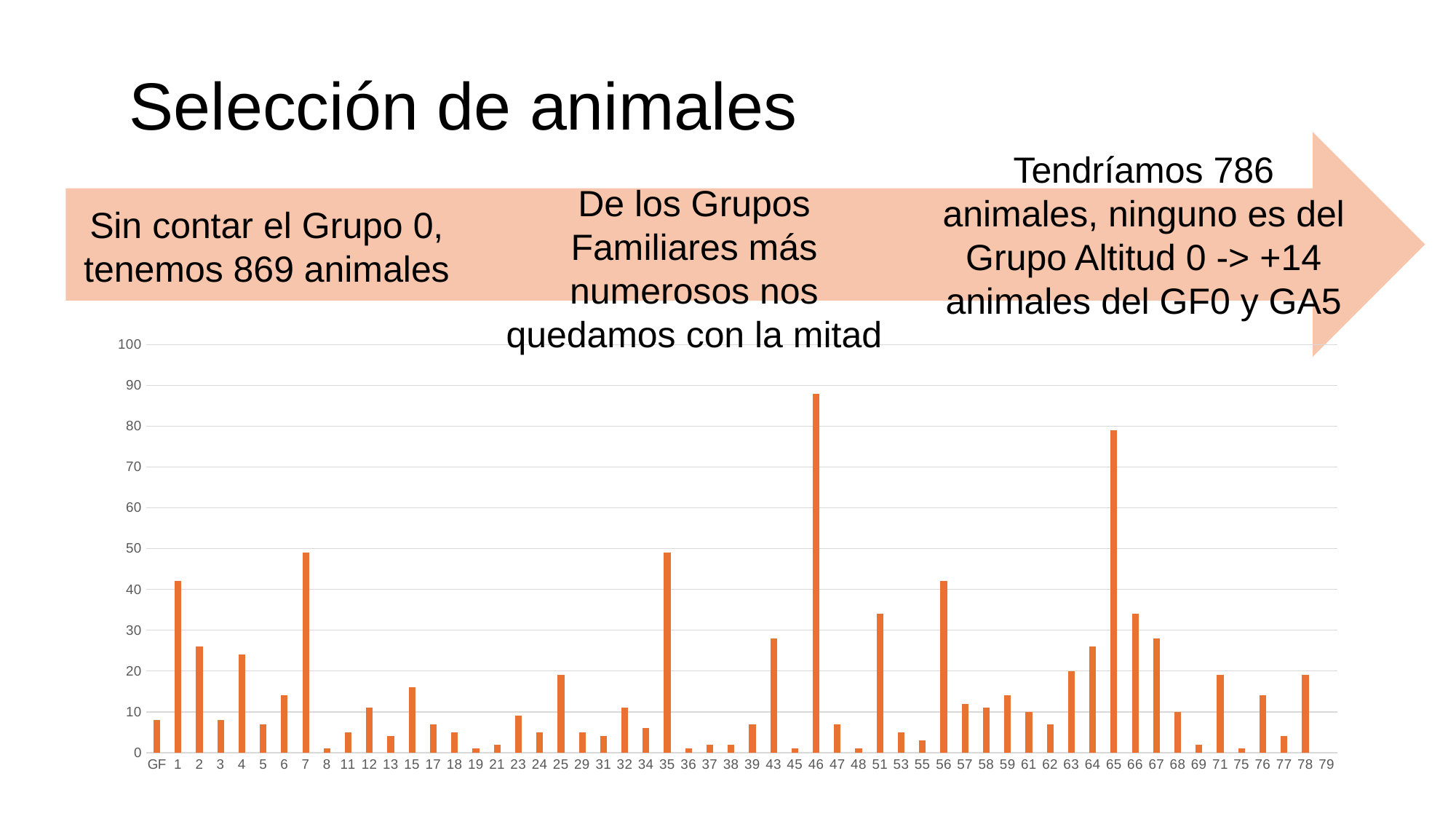
Which category has the highest bar in the chart? 46 Is the value for category 64 greater or less than 20? greater What kind of chart is shown on the slide? bar chart Which has the larger value, category 56 or category 51? 56 Is the value for category 43 greater or less than 30? less Which has the larger value, category 1 or category 2? 1 What colour are the bars in the chart? orange Is the value for category 46 greater or less than 80? greater Which has the larger value, category 46 or category 65? 46